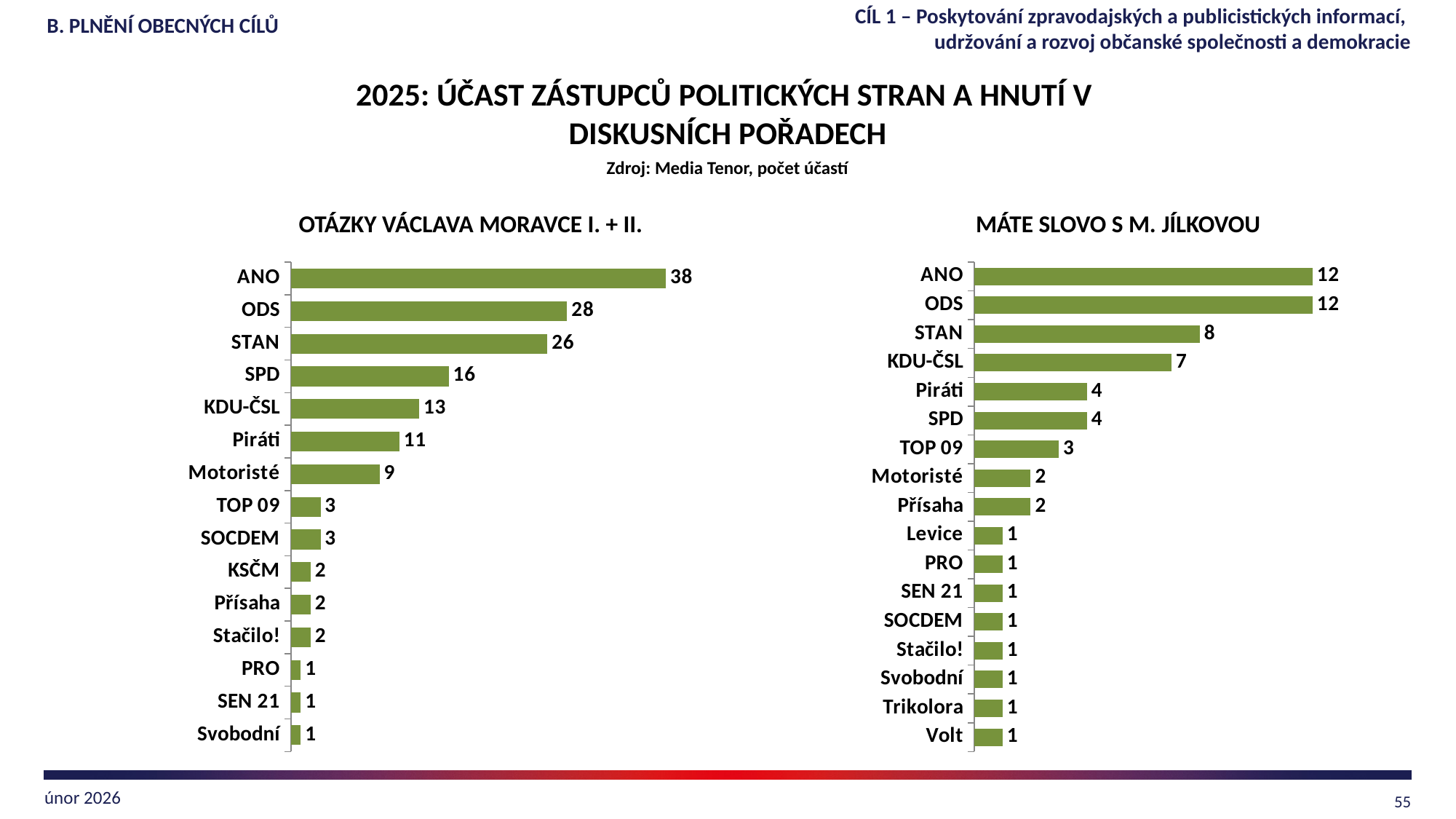
In the chart titled OTÁZKY VÁCLAVA MORAVCE I. + II., which is larger, the value for SPD or the value for Piráti? SPD In the chart titled MÁTE SLOVO S M. JÍLKOVOU, what is the difference between the values for ANO and KDU-ČSL? 5 In the chart titled MÁTE SLOVO S M. JÍLKOVOU, what is the value for TOP 09? 3 How many parties are shown in the chart titled MÁTE SLOVO S M. JÍLKOVOU? 17 In the chart titled OTÁZKY VÁCLAVA MORAVCE I. + II., what is the value for KDU-ČSL? 13 In the chart titled OTÁZKY VÁCLAVA MORAVCE I. + II., what is the difference between the values for ODS and STAN? 2 In the chart titled OTÁZKY VÁCLAVA MORAVCE I. + II., which party has the highest value? ANO In the chart titled OTÁZKY VÁCLAVA MORAVCE I. + II., what is the value for ANO? 38 What kind of chart is the chart titled MÁTE SLOVO S M. JÍLKOVOU? Bar chart How many parties are shown in the chart titled OTÁZKY VÁCLAVA MORAVCE I. + II.? 15 In the chart titled MÁTE SLOVO S M. JÍLKOVOU, what is the value for STAN? 8 In the chart titled MÁTE SLOVO S M. JÍLKOVOU, which is larger, the value for STAN or the value for Motoristé? STAN